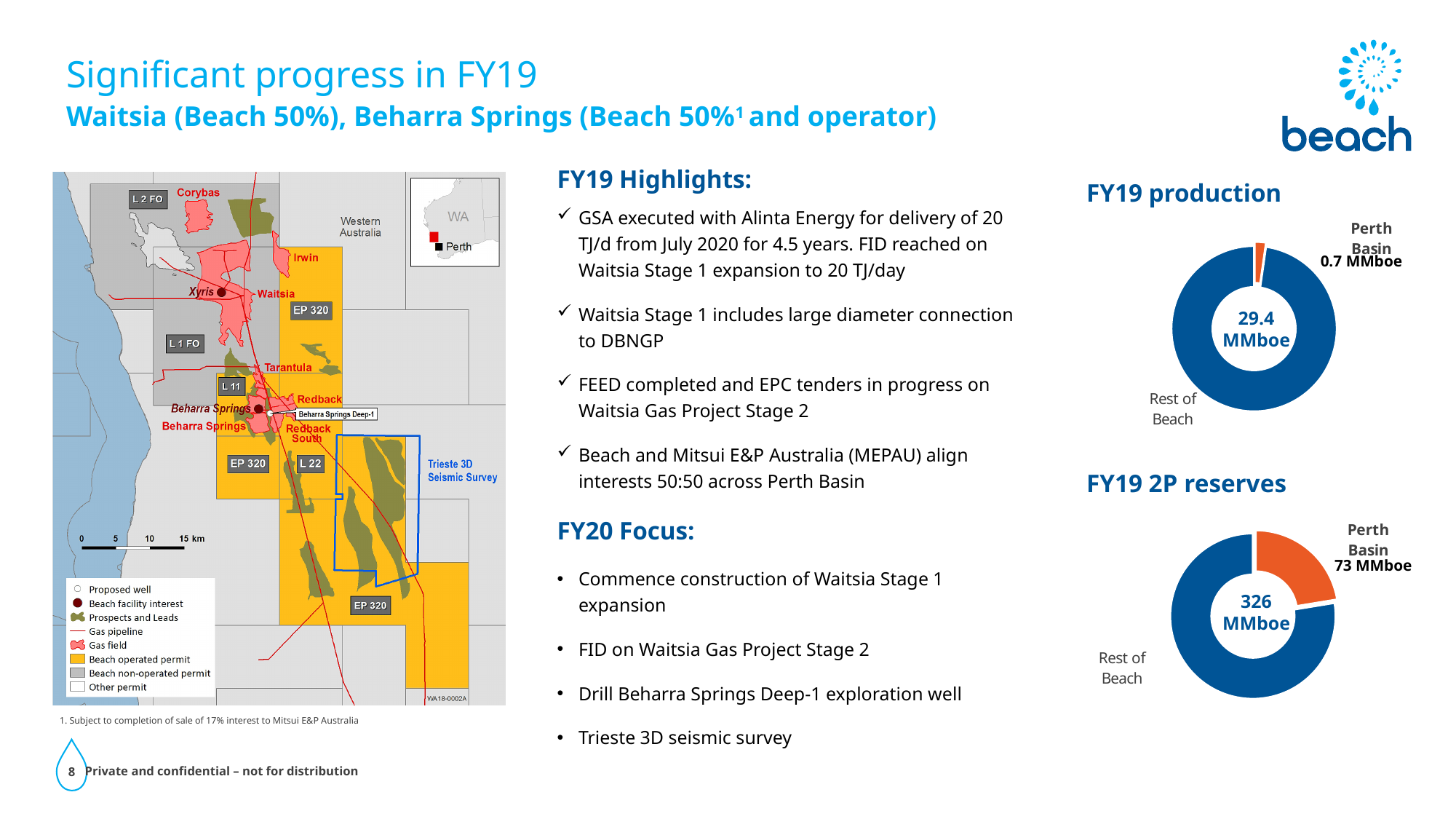
How many segments does the FY19 2P reserves chart have? 2 In the FY19 production chart, which segment is the smallest? Perth Basin In the FY19 2P reserves chart, what is the value for Perth Basin? 73 MMboe What is the title of the lower donut chart on the slide? FY19 2P reserves In the FY19 production chart, what is the value for Rest of Beach, given the total and the Perth Basin value? 28.7 MMboe What colour is the Perth Basin segment in the FY19 2P reserves chart? Orange In the FY19 2P reserves chart, what total is shown in the centre of the donut? 326 MMboe In the FY19 2P reserves chart, what is the value for Rest of Beach, given the total and the Perth Basin value? 253 MMboe In the FY19 2P reserves chart, which segment is larger, Perth Basin or Rest of Beach? Rest of Beach What kind of chart is the FY19 production chart? Donut (pie) chart In the FY19 production chart, what is the value for Perth Basin? 0.7 MMboe In the FY19 production chart, what total is shown in the centre of the donut? 29.4 MMboe